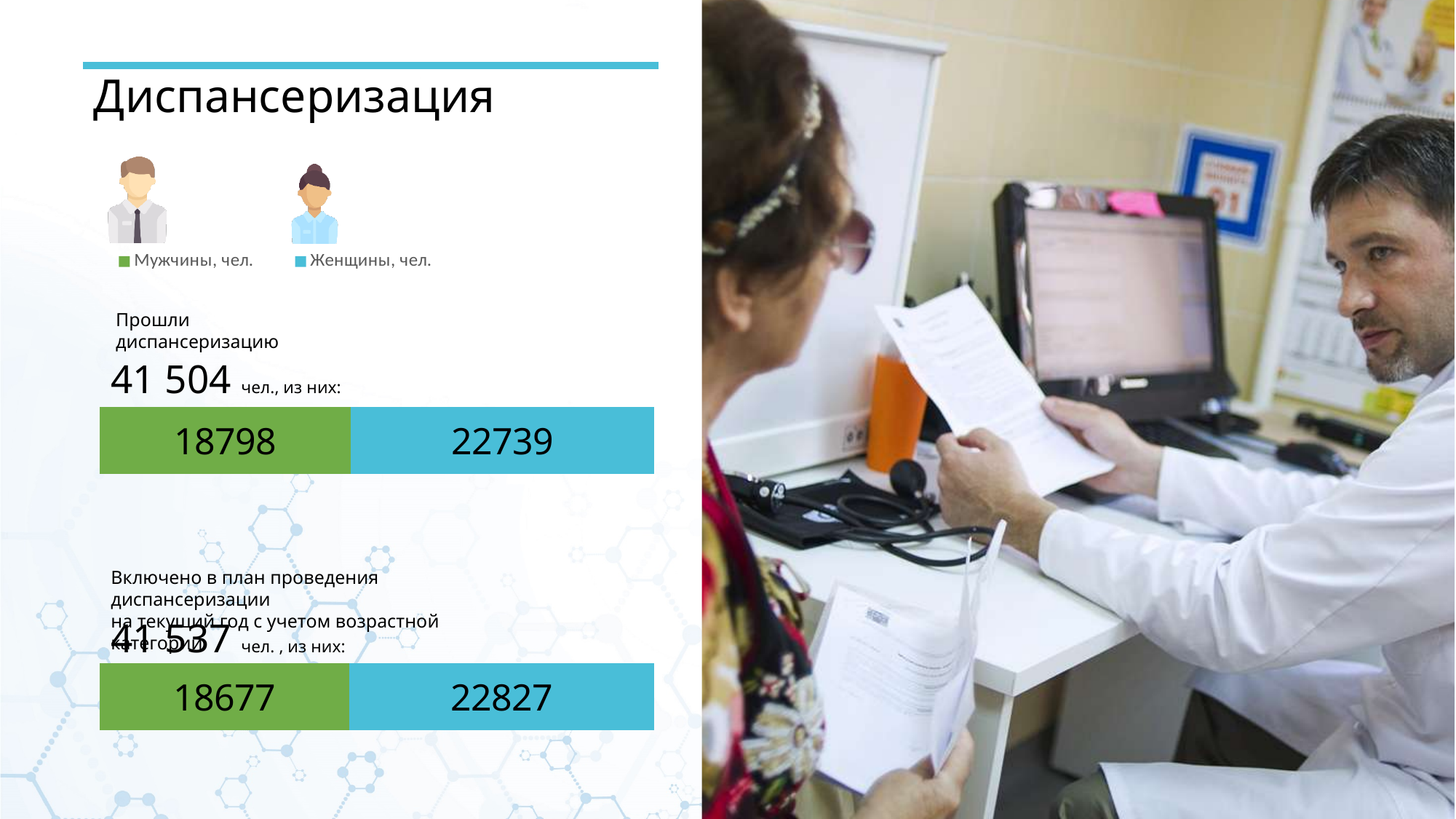
In the 'Прошли диспансеризацию' bar, which group is larger, Мужчины or Женщины? Женщины What type of chart is used to show the men and women figures? Stacked bar chart Which is larger: the Мужчины value in 'Прошли диспансеризацию' or the Мужчины value in 'Включено в план проведения диспансеризации'? Прошли диспансеризацию (18798) In the 'Прошли диспансеризацию' bar, what is the difference between the Женщины and Мужчины values? 3941 Which colour represents Женщины, чел. in the bars? Blue How many series does the legend list? 2 In the 'Включено в план проведения диспансеризации' bar, what is the difference between the Женщины and Мужчины values? 4150 In the 'Включено в план проведения диспансеризации' bar, what is the value for Женщины, чел.? 22827 In the 'Включено в план проведения диспансеризации' bar, what is the value for Мужчины, чел.? 18677 In the 'Прошли диспансеризацию' bar, what is the value for Мужчины, чел.? 18798 In the 'Прошли диспансеризацию' bar, what is the value for Женщины, чел.? 22739 In the 'Включено в план проведения диспансеризации' bar, which group is smaller, Мужчины or Женщины? Мужчины